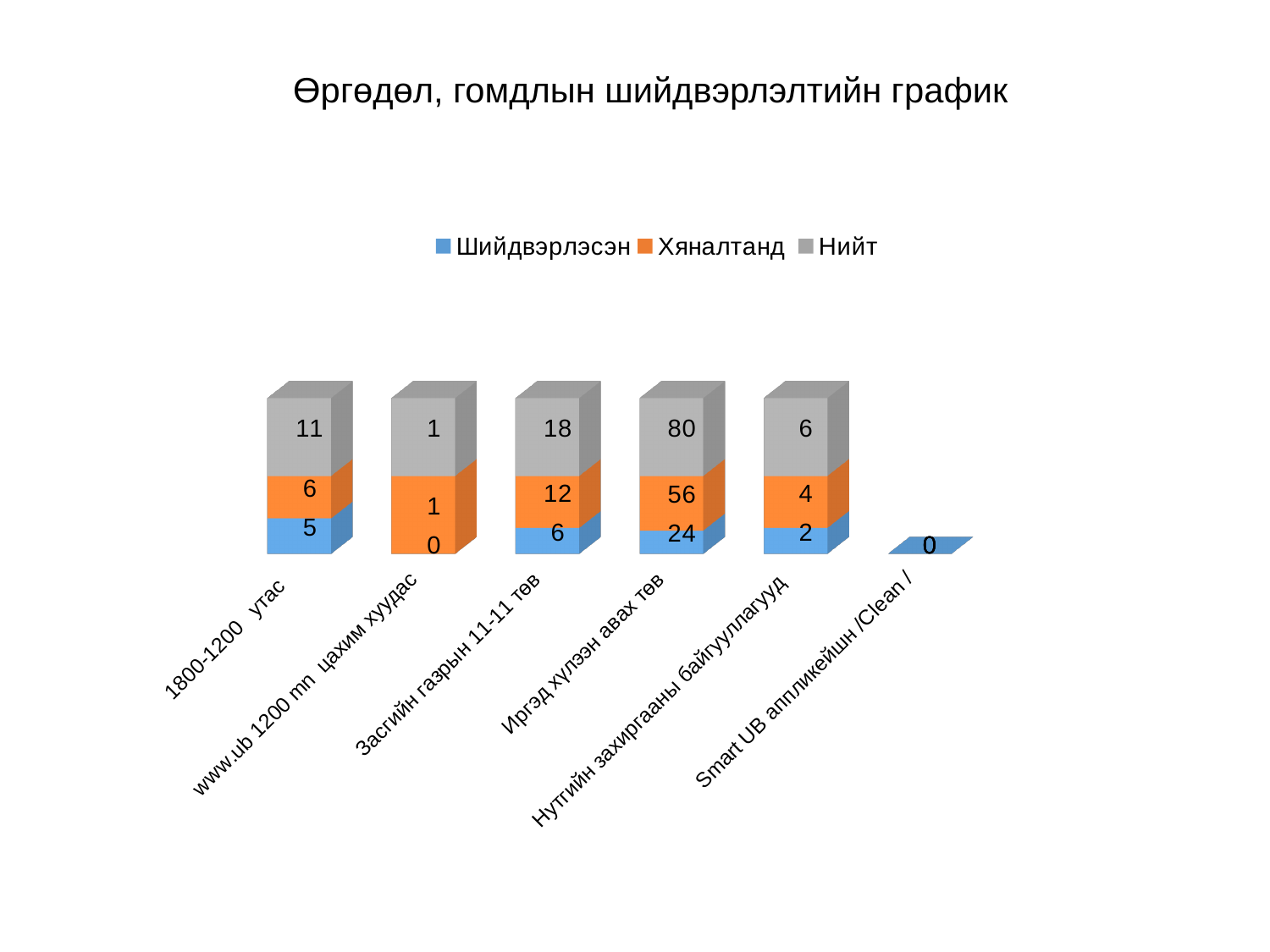
What kind of chart is shown on the slide? Stacked bar chart Which category has the highest Нийт value? Иргэд хүлээн авах төв What is the Хяналтанд value for Засгийн газрын 11-11 төв? 12 Which category has the highest Хяналтанд value? Иргэд хүлээн авах төв What is the difference between the Хяналтанд values for Иргэд хүлээн авах төв and Засгийн газрын 11-11 төв? 44 How many series does the legend list? 3 How many categories are shown on the x axis? 6 What is the Шийдвэрлэсэн value for www.ub 1200 mn цахим хуудас? 0 Which is larger: the Нийт value for 1800-1200 утас or for Засгийн газрын 11-11 төв? Засгийн газрын 11-11 төв What is the Шийдвэрлэсэн value for 1800-1200 утас? 5 What is the Нийт value for Иргэд хүлээн авах төв? 80 What is the Хяналтанд value for Нутгийн захиргааны байгууллагууд? 4